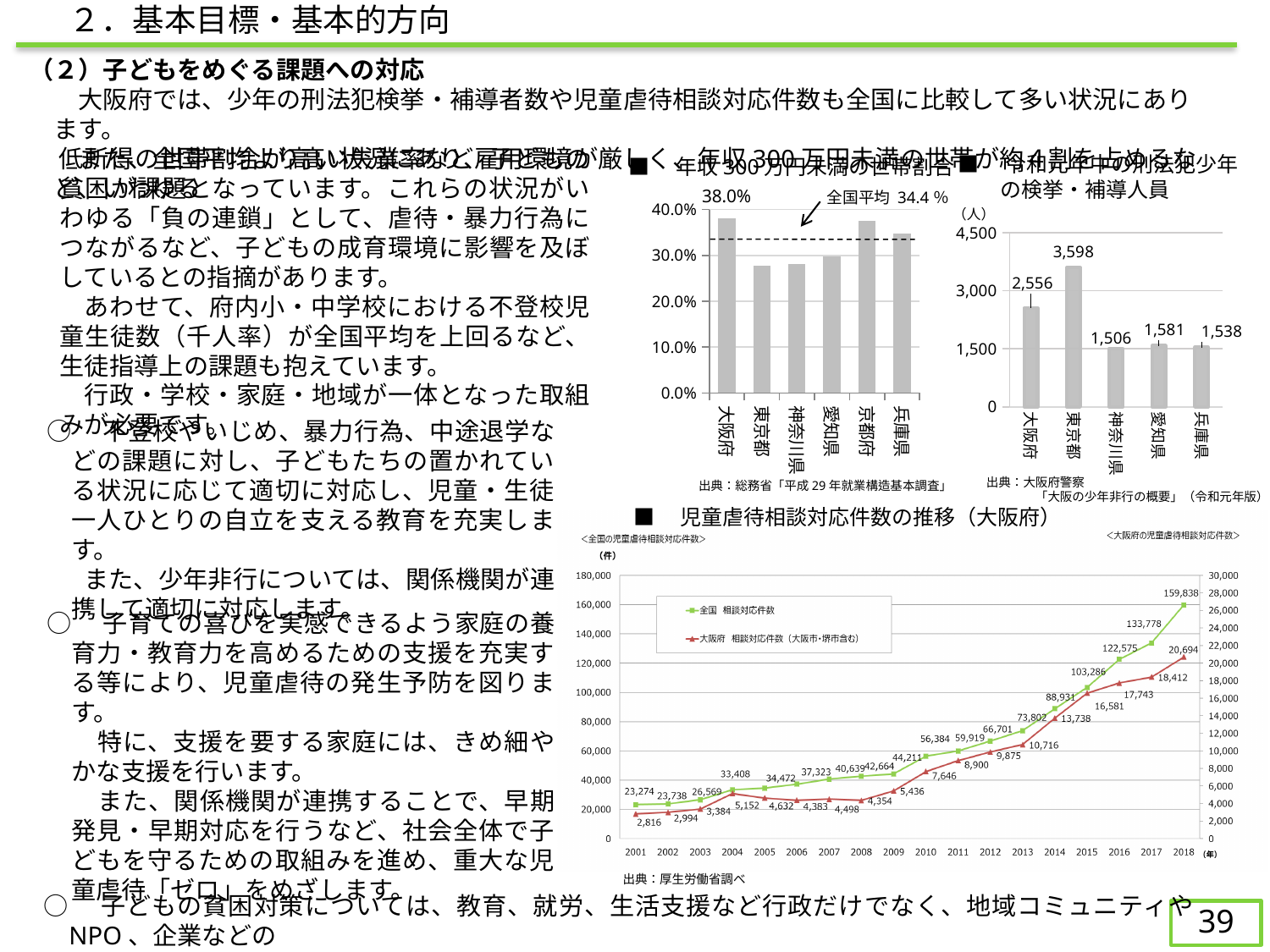
In the top-left bar chart (年収300万円未満の世帯割合), is the value for 東京都 greater or less than 30.0%? less In the bottom line chart (児童虐待相談対応件数の推移), what is the 大阪府 value for 2001? 2,816 In the bottom line chart (児童虐待相談対応件数の推移), how many series does the legend list? 2 In the top-right bar chart (令和元年中の刑法犯少年の検挙・補導人員), what is the value for 大阪府? 2,556 In the top-left bar chart (年収300万円未満の世帯割合), what is the value for 大阪府? 38.0% In the bottom line chart (児童虐待相談対応件数の推移), does the 全国 series generally rise or fall from 2001 to 2018? rise In the top-right bar chart (令和元年中の刑法犯少年の検挙・補導人員), what is the value for 東京都? 3,598 In the top-right bar chart (令和元年中の刑法犯少年の検挙・補導人員), what is the difference between 東京都 and 大阪府? 1,042 In the top-left bar chart (年収300万円未満の世帯割合), which prefecture has the highest value? 大阪府 In the bottom line chart (児童虐待相談対応件数の推移), what is the 全国 value for 2018? 159,838 In the top-right bar chart (令和元年中の刑法犯少年の検挙・補導人員), how many prefectures are shown? 5 In the top-right bar chart (令和元年中の刑法犯少年の検挙・補導人員), which prefecture has the lowest value? 神奈川県